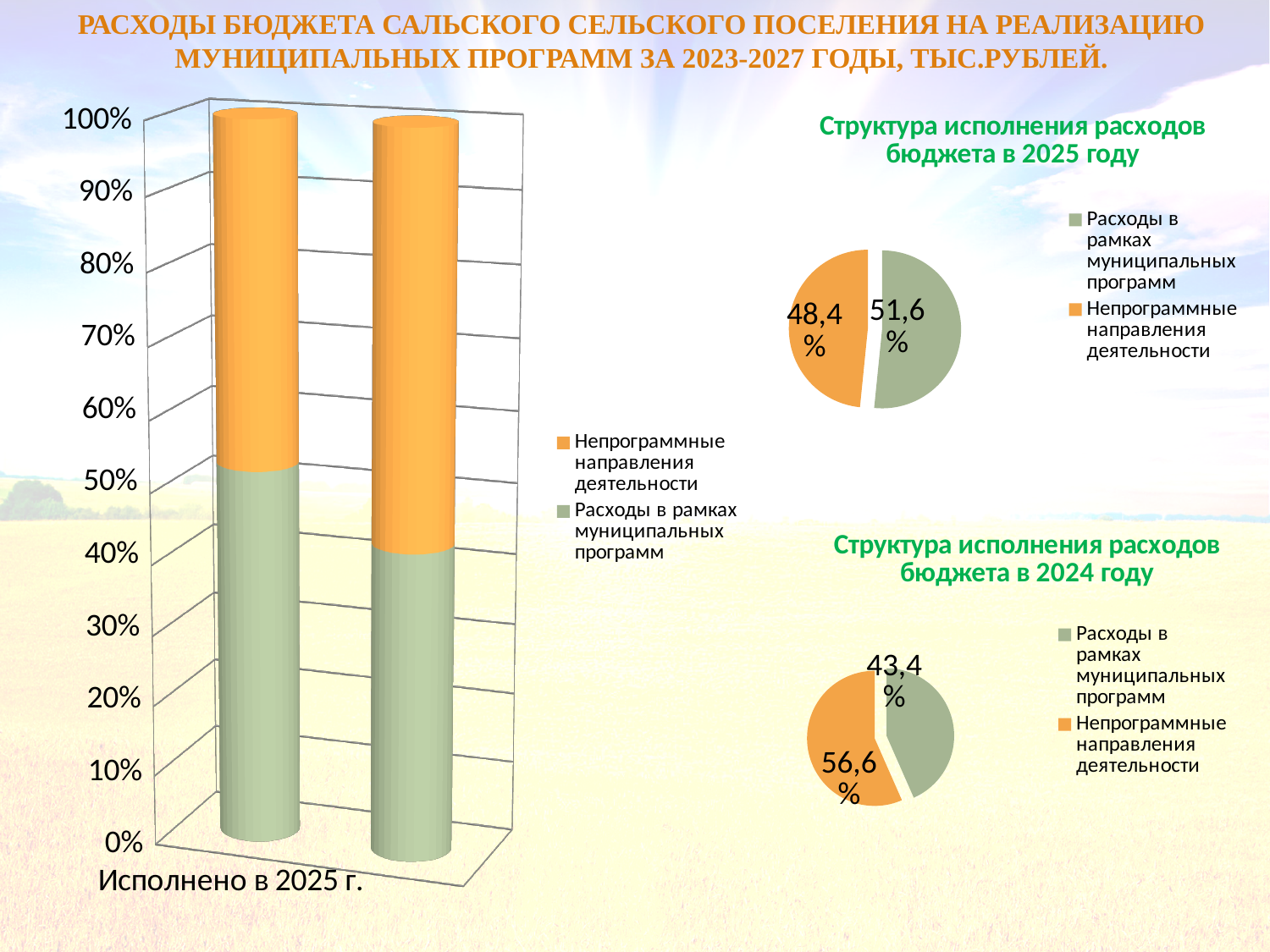
Is the share of 'Непрограммные направления деятельности' larger in the 2024 pie chart or in the 2025 pie chart? 2024 In the pie chart titled 'Структура исполнения расходов бюджета в 2025 году', what share is labelled for 'Непрограммные направления деятельности'? 48,4% In the pie chart titled 'Структура исполнения расходов бюджета в 2024 году', what share is labelled for 'Непрограммные направления деятельности'? 56,6% In the pie chart titled 'Структура исполнения расходов бюджета в 2025 году', which slice is larger? Расходы в рамках муниципальных программ How many slices does the pie chart titled 'Структура исполнения расходов бюджета в 2024 году' have? 2 In the pie chart titled 'Структура исполнения расходов бюджета в 2024 году', which slice is smaller? Расходы в рамках муниципальных программ In the pie chart titled 'Структура исполнения расходов бюджета в 2024 году', what is the difference between the two slices? 13,2% In the pie chart titled 'Структура исполнения расходов бюджета в 2025 году', what share is labelled for 'Расходы в рамках муниципальных программ'? 51,6% In the pie chart titled 'Структура исполнения расходов бюджета в 2024 году', what share is labelled for 'Расходы в рамках муниципальных программ'? 43,4% How many series does the legend of the bar chart on the left list? 2 In the pie chart titled 'Структура исполнения расходов бюджета в 2025 году', what is the difference between the two slices? 3,2% What kind of chart is the large chart on the left of the slide? Stacked bar chart